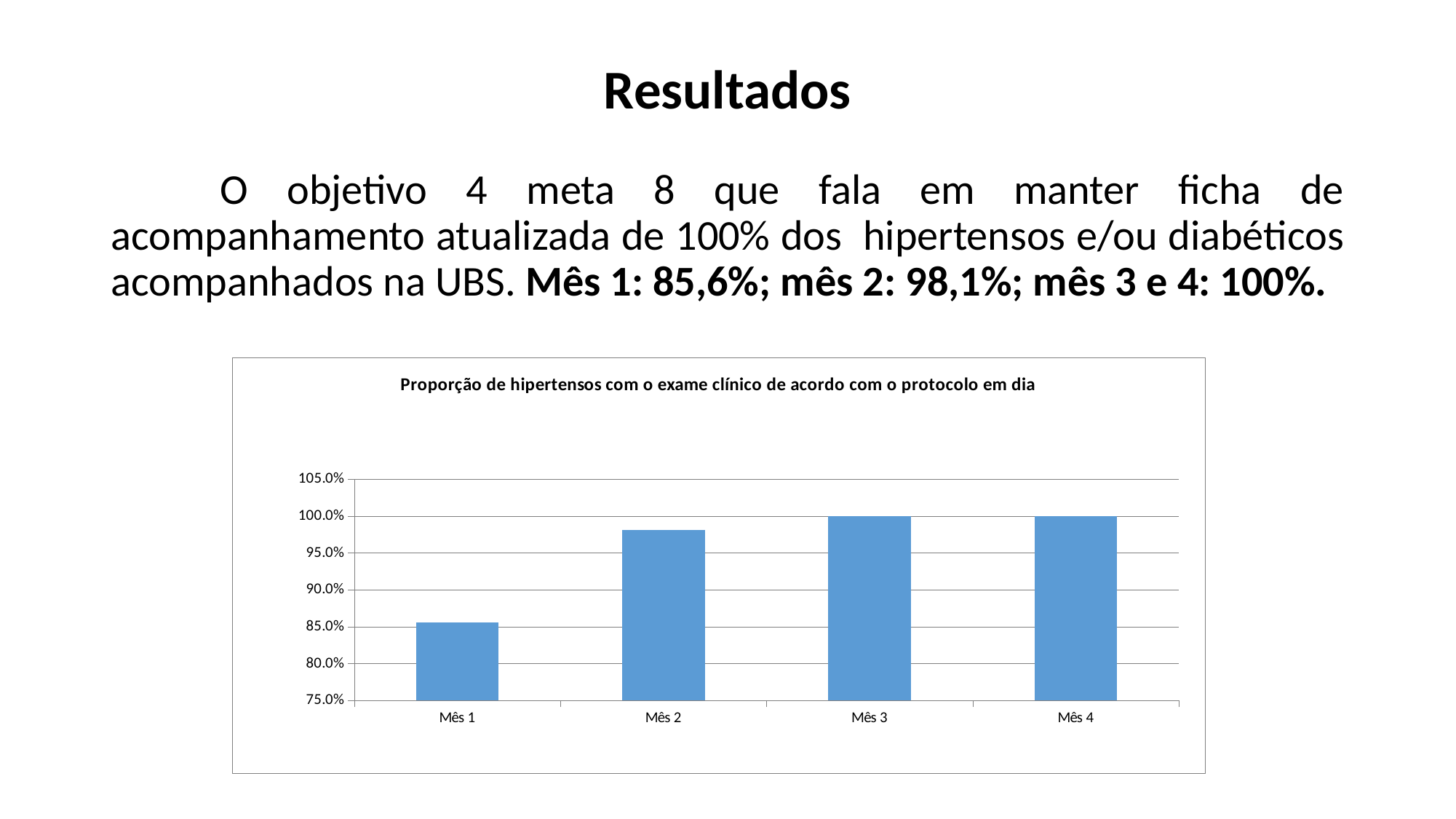
Is the value for Mês 2 greater or less than 95.0%? greater What is the value for Mês 4 in the chart? 100.0% Which is larger, the value for Mês 1 or the value for Mês 2? Mês 2 What is the lowest value shown on the vertical axis of the chart? 75.0% What is the value for Mês 3 in the chart? 100.0% What is the title of the chart? Proporção de hipertensos com o exame clínico de acordo com o protocolo em dia What kind of chart is shown on the slide? bar chart Is the value for Mês 1 greater or less than 90.0%? less Do the values rise or fall from Mês 1 to Mês 4? rise Which month has the lowest value in the chart? Mês 1 Is the value for Mês 1 greater or less than 85.0%? greater How many categories (months) are plotted in the chart? 4